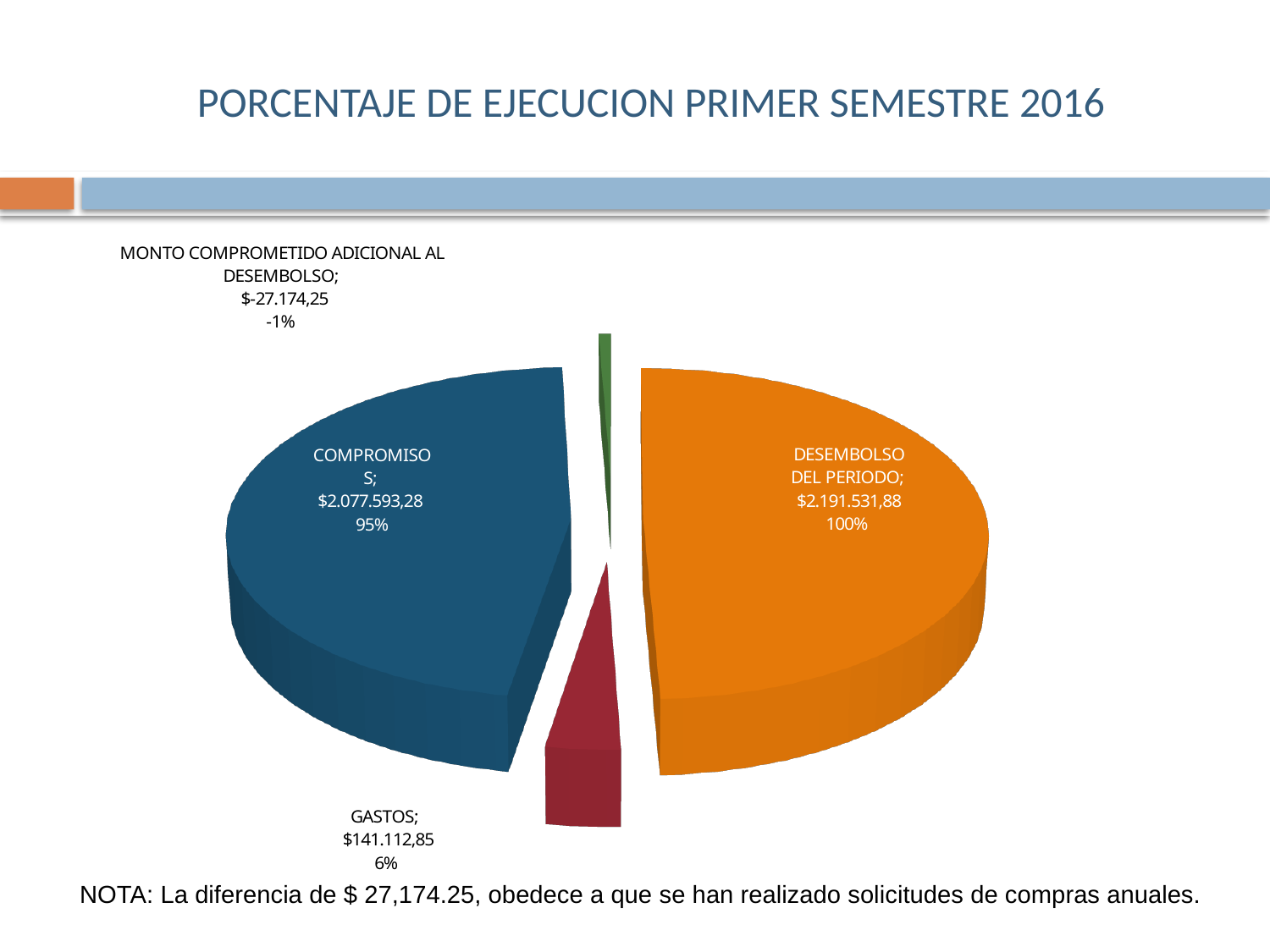
What is the title of the slide containing the chart? PORCENTAJE DE EJECUCION PRIMER SEMESTRE 2016 What is the value shown for GASTOS? $141.112,85 How many slices does the pie chart have? 4 Which slice has the largest value? DESEMBOLSO DEL PERIODO What percentage is shown for the GASTOS slice? 6% What is the value shown for COMPROMISOS? $2.077.593,28 Which is larger, the value for COMPROMISOS or the value for GASTOS? COMPROMISOS Which slice has the smallest value? MONTO COMPROMETIDO ADICIONAL AL DESEMBOLSO What kind of chart is shown on the slide? Pie chart What is the value shown for DESEMBOLSO DEL PERIODO? $2.191.531,88 What is the value shown for MONTO COMPROMETIDO ADICIONAL AL DESEMBOLSO? $-27.174,25 What percentage is shown for the COMPROMISOS slice? 95%